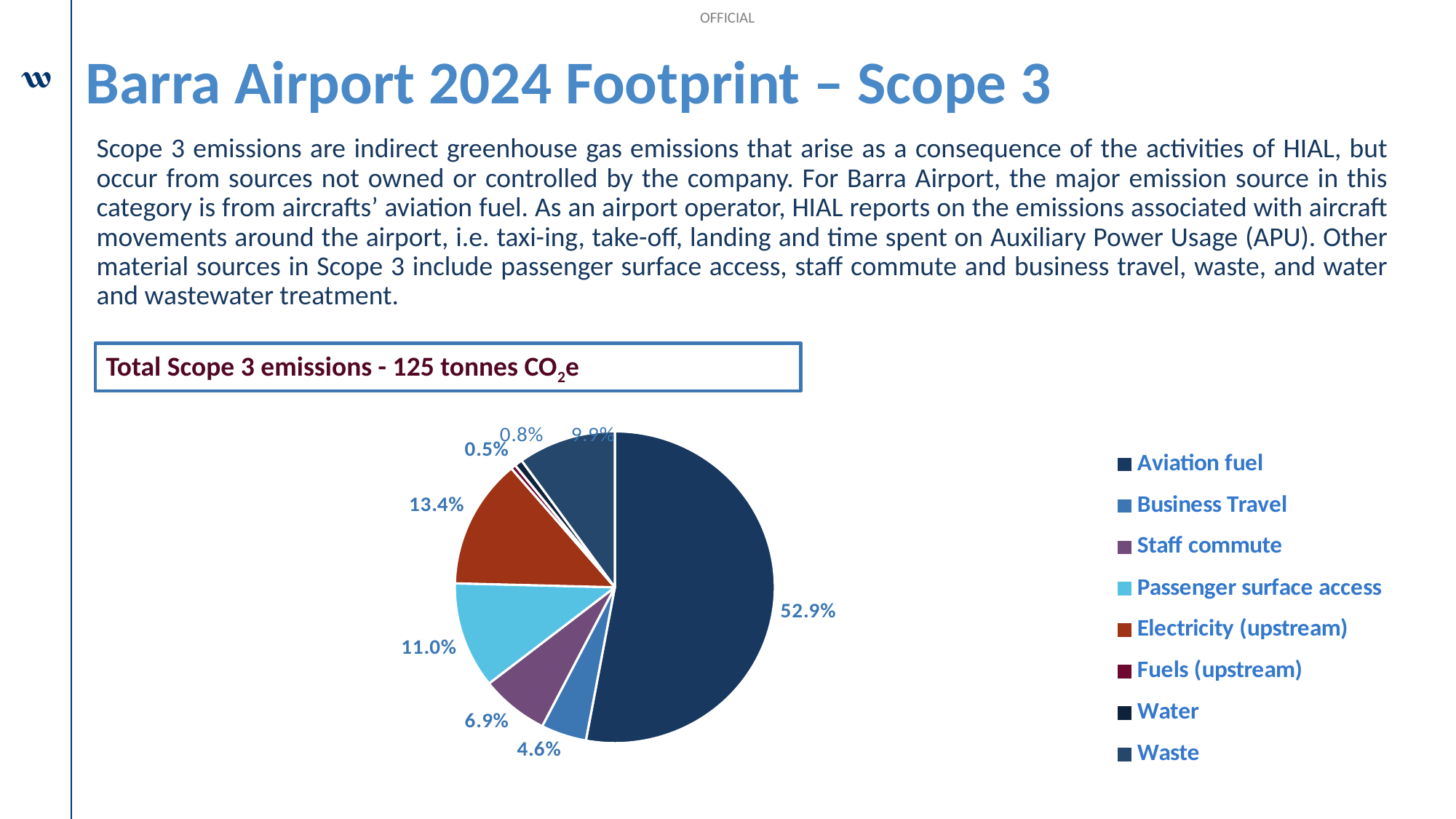
What share of the pie does Aviation fuel account for? 52.9% Which is larger, the share for Staff commute or the share for Business Travel? Staff commute How many categories does the legend list? 8 Which category has the smallest slice of the pie? Fuels (upstream) What percentage is shown for Passenger surface access? 11.0% What kind of chart is shown on the slide? Pie chart What percentage is shown for Electricity (upstream)? 13.4% What total Scope 3 emissions figure is stated in the box above the chart? 125 tonnes CO2e What percentage is shown for Waste? 9.9% What percentage is shown for Business Travel? 4.6% Which category has the largest slice of the pie? Aviation fuel What is the difference in percentage points between Electricity (upstream) and Passenger surface access? 2.4